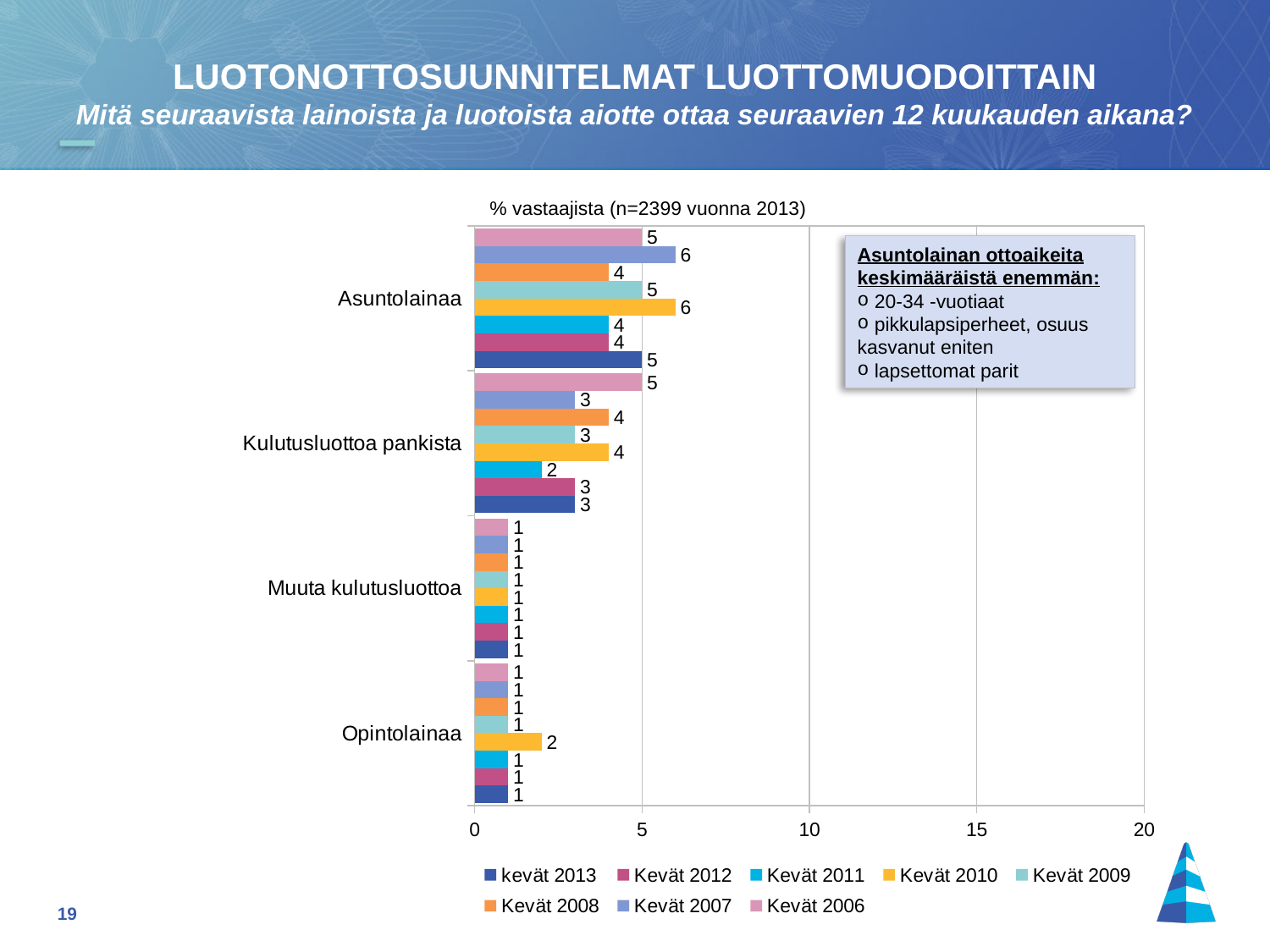
For Kulutusluottoa pankista, which is larger: the Kevät 2006 value or the Kevät 2011 value? Kevät 2006 How many loan categories are shown on the chart? 4 What is the value for Opintolainaa in the Kevät 2010 series? 2 What kind of chart is shown on the slide? bar chart How many series does the legend list? 8 What is the difference between the Kevät 2006 and kevät 2013 values for Kulutusluottoa pankista? 2 What is the value for Kulutusluottoa pankista in the Kevät 2006 series? 5 What is the axis label shown above the chart? % vastaajista (n=2399 vuonna 2013) What is the difference between the Kevät 2010 and Kevät 2011 values for Asuntolainaa? 2 What is the value for Kulutusluottoa pankista in the Kevät 2011 series? 2 Which category has the highest value in the kevät 2013 series? Asuntolainaa What is the value for Asuntolainaa in the kevät 2013 series? 5